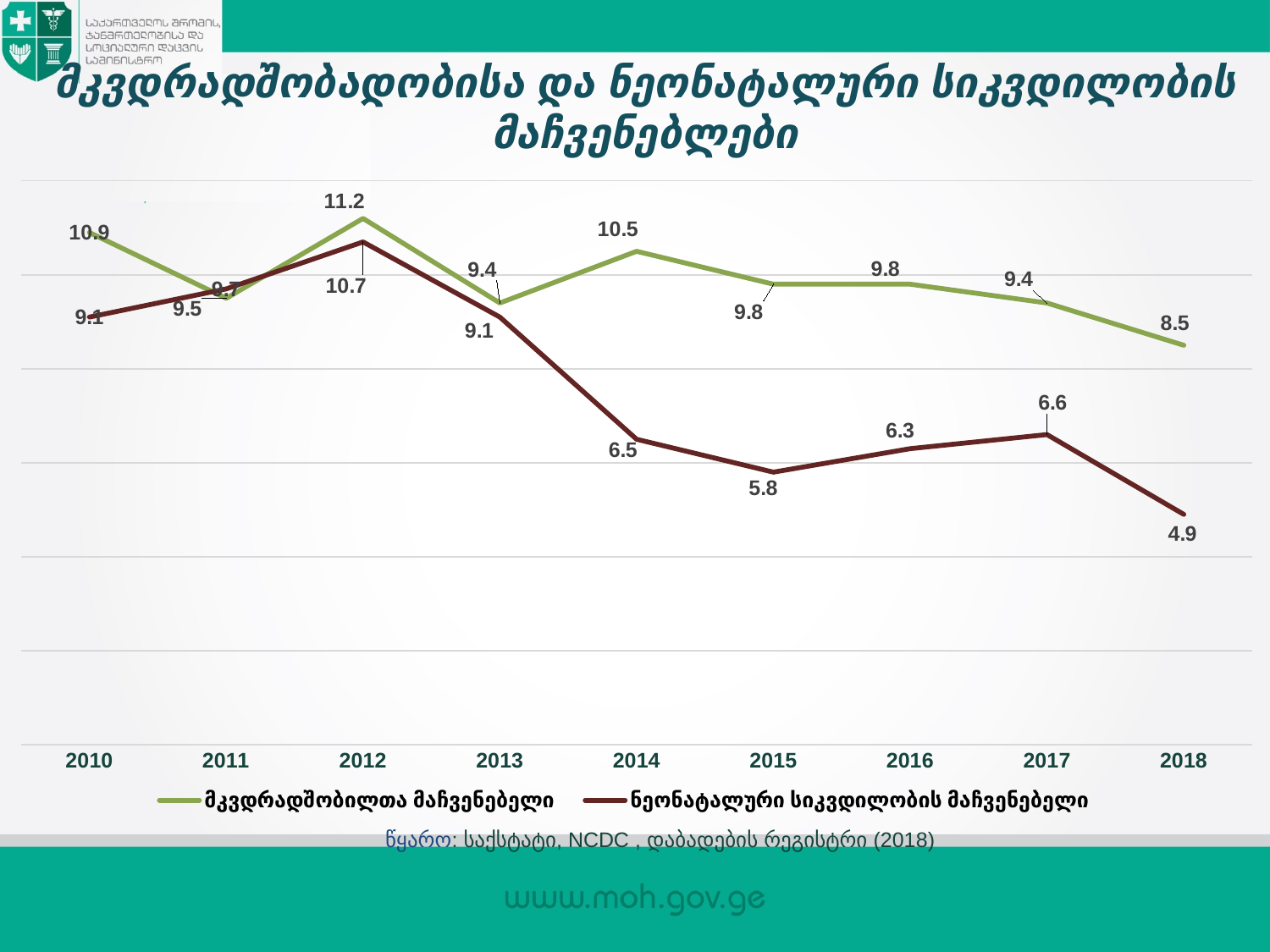
What colour is the line for ნეონატალური სიკვდილობის მაჩვენებელი? dark red What is the value of the მკვდრადშობილთა მაჩვენებელი (green) series in 2012? 11.2 What is the value of the ნეონატალური სიკვდილობის მაჩვენებელი (dark red) series in 2015? 5.8 How many series does the legend list? 2 What is the difference between the two series in 2018? 3.6 How many years are shown on the x axis? 9 Which series has the higher value in 2014? მკვდრადშობილთა მაჩვენებელი Does the ნეონატალური სიკვდილობის მაჩვენებელი (dark red) series rise or fall from 2017 to 2018? fall What is the value of the ნეონატალური სიკვდილობის მაჩვენებელი (dark red) series in 2018? 4.9 In which year is the მკვდრადშობილთა მაჩვენებელი (green) series highest? 2012 In which year is the ნეონატალური სიკვდილობის მაჩვენებელი (dark red) series lowest? 2018 What type of chart is shown on the slide? line chart